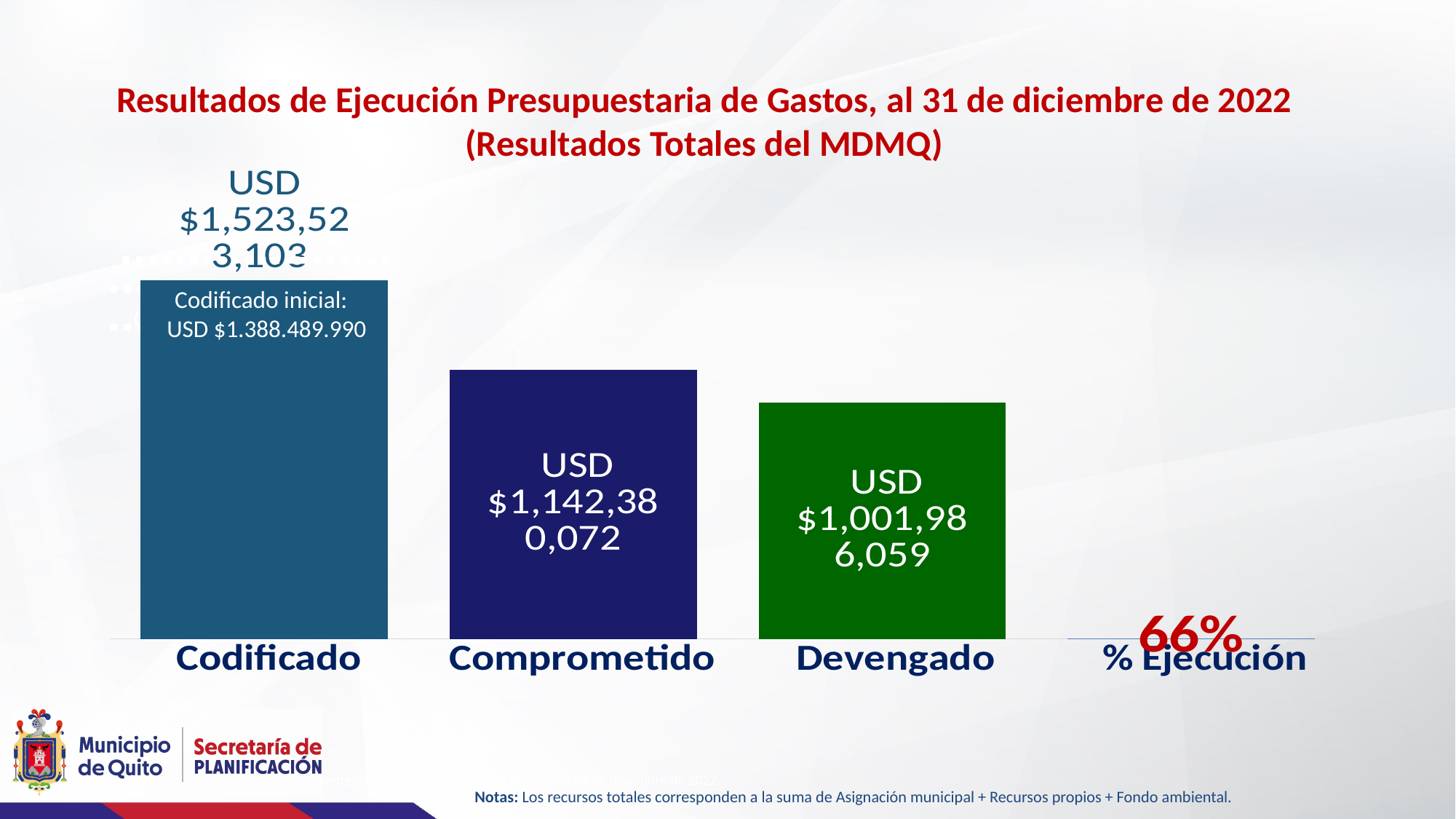
Which of the three bars is the shortest? Devengado What is the value shown for Devengado? USD $1,001,986,059 Which category has the tallest bar? Codificado What kind of chart is shown on the slide? bar chart What is the Codificado inicial value printed inside the Codificado bar? USD $1.388.489.990 How many bars are plotted in the chart? 3 What is the difference between the Comprometido and Devengado values? USD $140,394,013 What percentage is shown for % Ejecución? 66% Which is larger, Comprometido or Devengado? Comprometido What is the value shown for Comprometido? USD $1,142,380,072 Do the bar values rise or fall from Codificado to Devengado? fall What colour is the Devengado bar? green